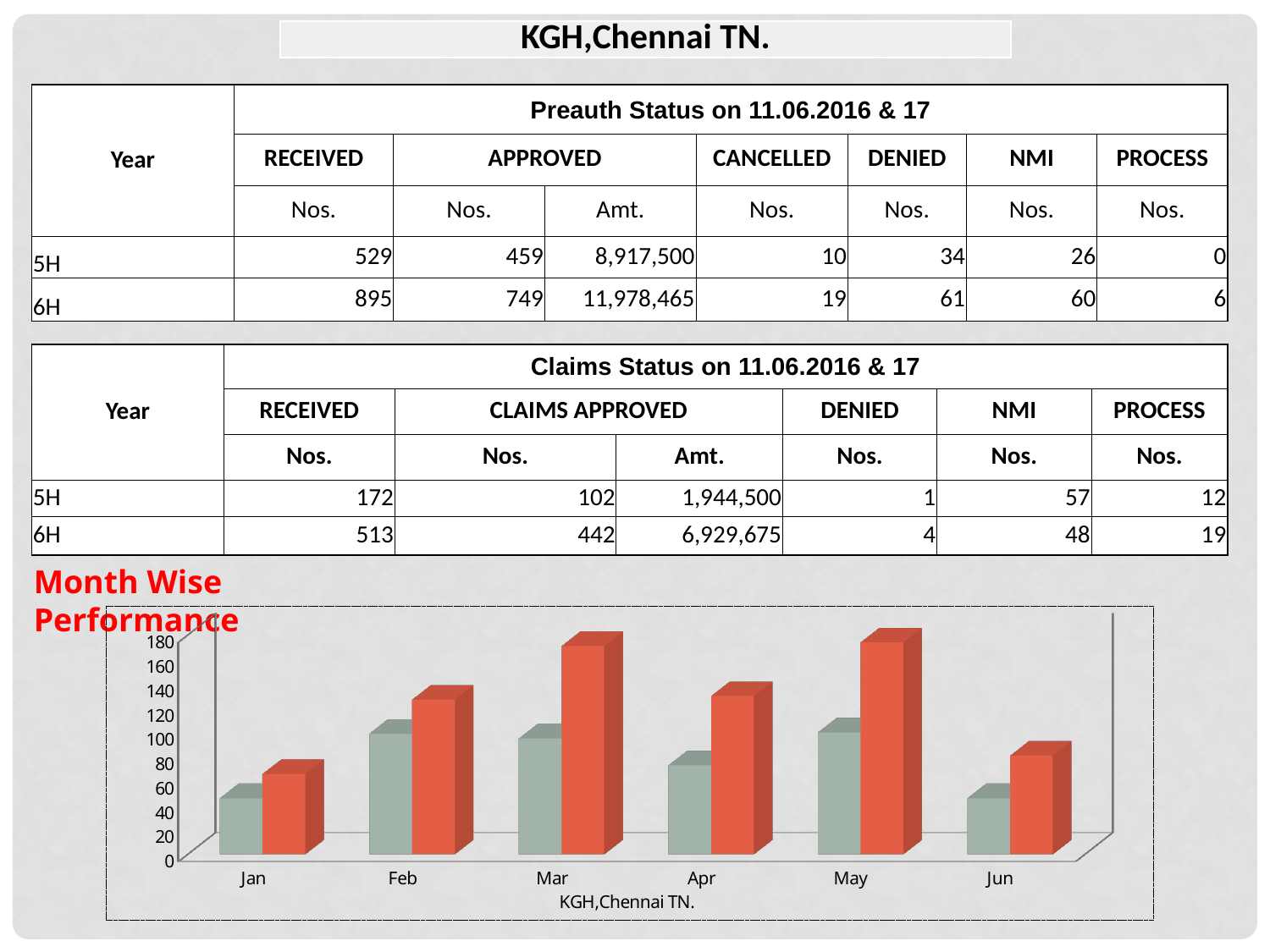
What kind of chart is shown under the heading "Month Wise Performance"? bar chart Is the value of the red bar for May greater or less than 140? greater Which is larger in the bar chart: the grey bar for Feb or the grey bar for Apr? Feb Is the value of the red bar for Jan greater or less than 100? less How many months are shown on the x axis of the bar chart? 6 Which is larger in the bar chart: the red bar for Mar or the red bar for Apr? Mar Is the value of the red bar for Mar greater or less than 140? greater What title is printed below the x axis of the bar chart? KGH,Chennai TN. Does the red series rise or fall from Feb to Mar in the bar chart? rise What is the first month shown on the x axis of the bar chart? Jan